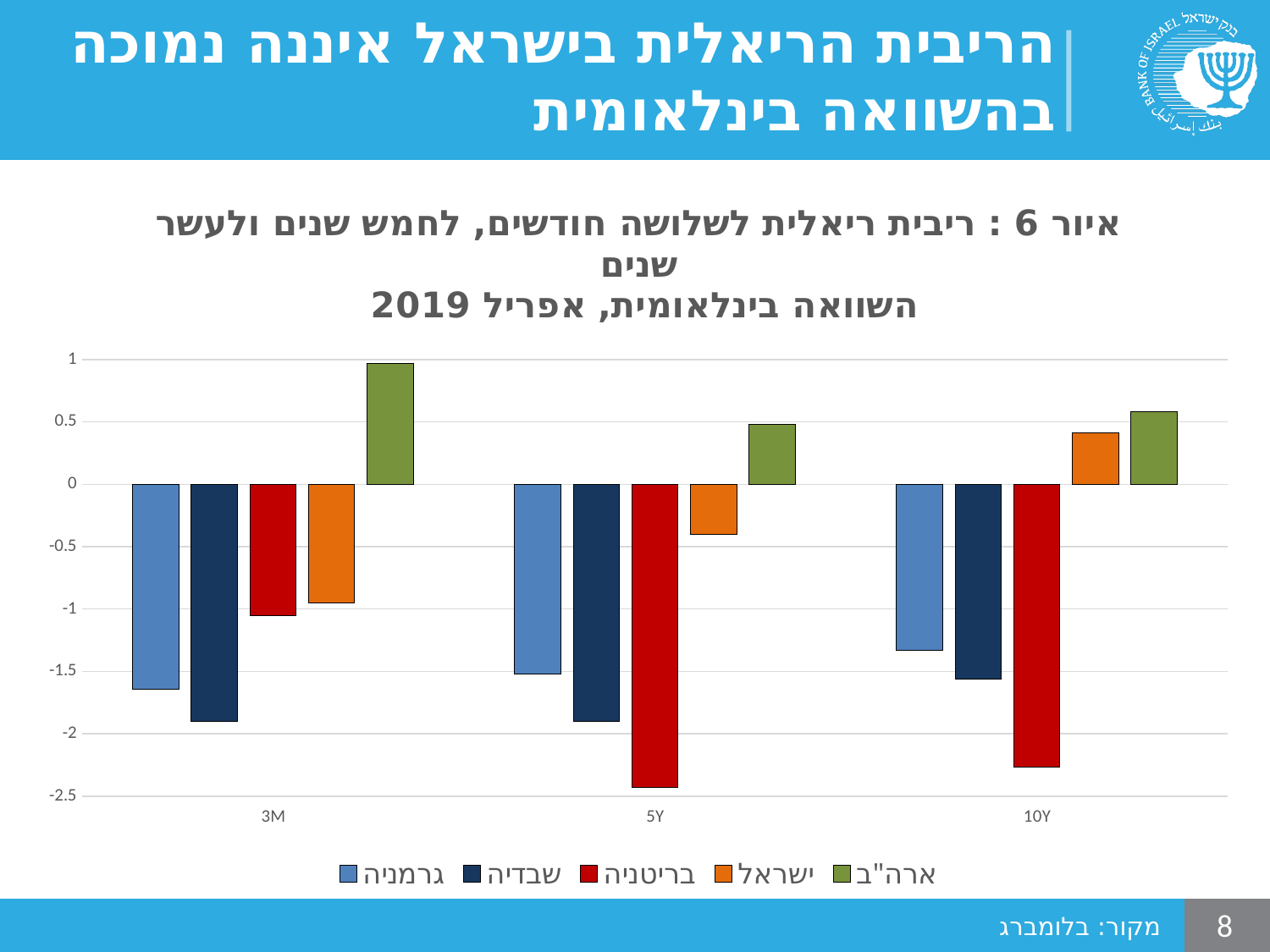
How many categories are shown on the x axis of the chart? 3 Which colour represents ישראל in the chart's legend? orange Is the value for ארה"ב in the 3M category greater or less than 0.5? greater What kind of chart is shown on the slide? bar chart In the 5Y category, which country has the highest value? ארה"ב Is the value for ישראל in the 3M category greater or less than -0.5? less How many series does the chart's legend list? 5 In the 10Y category, which is larger: the value for ישראל or the value for ארה"ב? ארה"ב Is the value for גרמניה in the 10Y category greater or less than -1.5? greater In the 5Y category, which country has the lowest value? בריטניה Which bar in the whole chart has the lowest value? בריטניה at 5Y